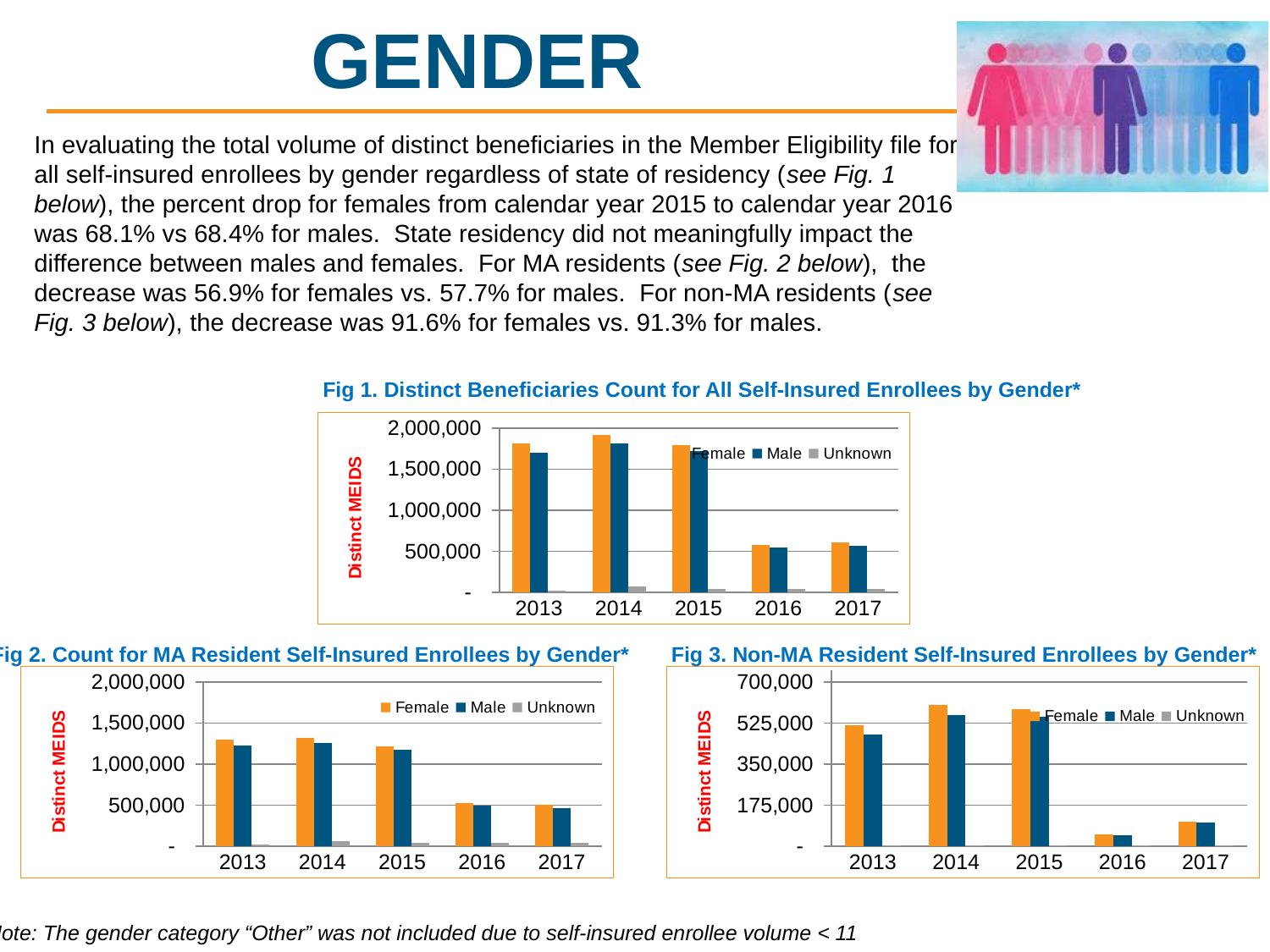
In Fig 1, which year has the highest Female value? 2014 In Fig 3, is the Male value for 2013 greater or less than 525,000? less In Fig 1, how many series does the legend list? 3 In Fig 2. Count for MA Resident Self-Insured Enrollees by Gender, which year has the highest Female value? 2014 In Fig 3. Non-MA Resident Self-Insured Enrollees by Gender, which year has the lowest Female value? 2016 In Fig 1, is the Female value for 2013 greater or less than 1,500,000? greater In Fig 1, which is larger for 2013, the Female value or the Male value? Female What kind of chart is Fig 1. Distinct Beneficiaries Count for All Self-Insured Enrollees by Gender? bar chart In Fig 1, how many years are shown on the x axis? 5 In Fig 3, what is the label of the y axis? Distinct MEIDS In Fig 1, do the Female values rise or fall from 2015 to 2016? fall